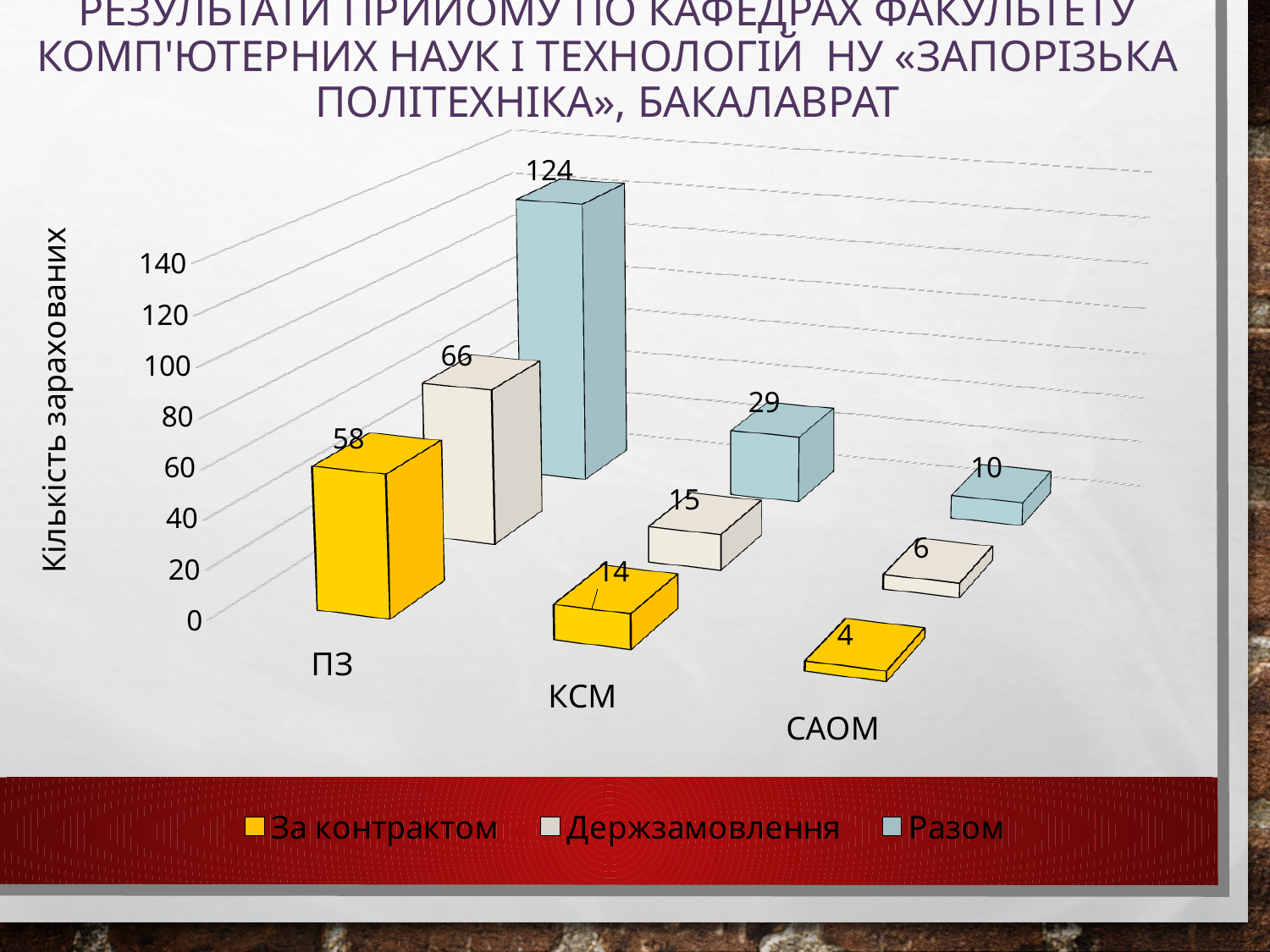
What is the difference between the Держзамовлення and За контрактом values for ПЗ? 8 What is the value of the За контрактом series for КСМ? 14 What is the label of the vertical axis? Кількість зарахованих Which is larger for КСМ: the Держзамовлення value or the За контрактом value? Держзамовлення How many categories are shown on the x axis? 3 What is the value of the Разом series for ПЗ? 124 What kind of chart is shown on the slide? bar chart How many series does the legend list? 3 Which category has the highest Разом value? ПЗ What is the value of the Держзамовлення series for САОМ? 6 Which category has the lowest За контрактом value? САОМ Is the Разом value for ПЗ greater or less than 100? greater